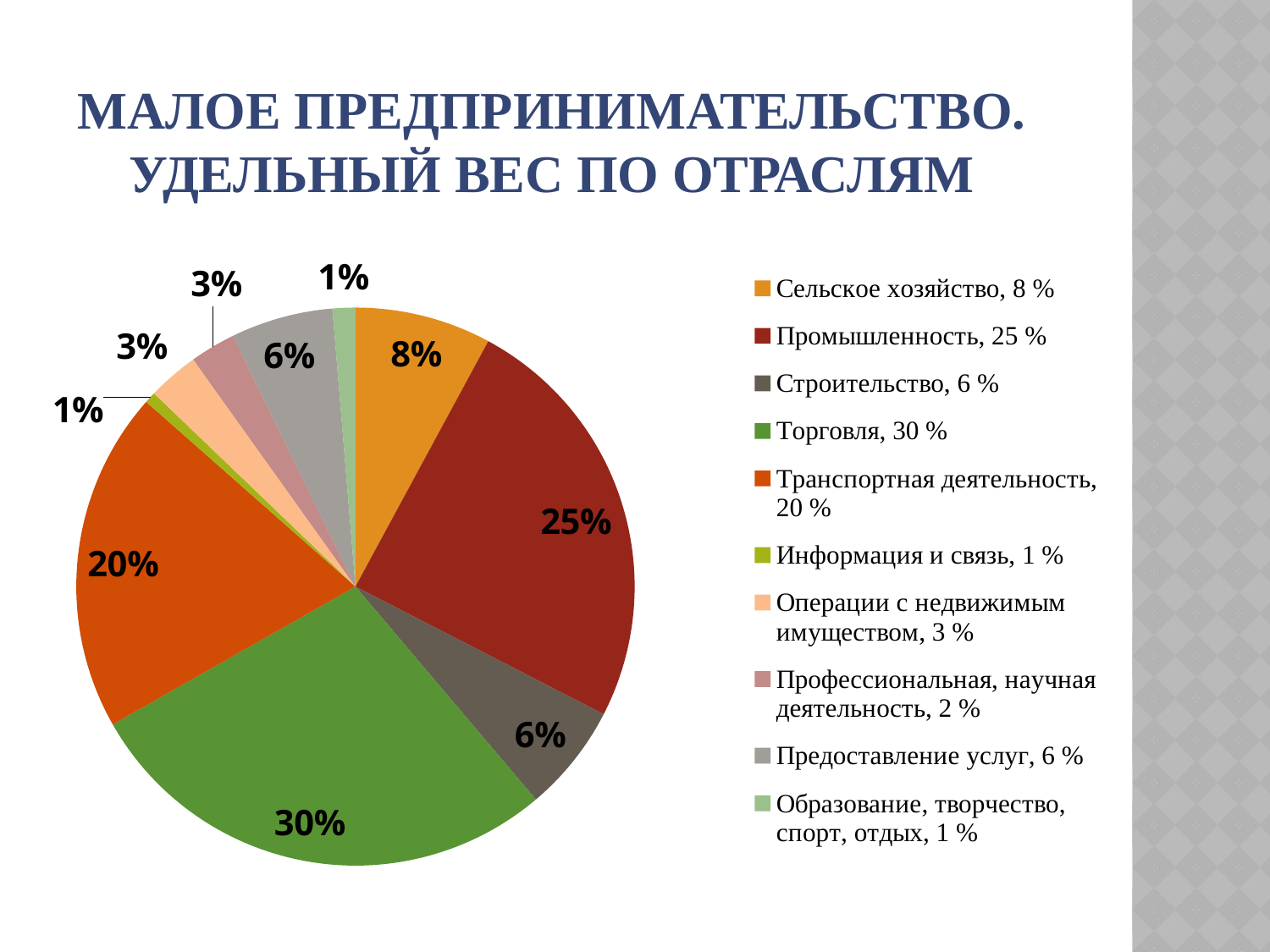
What kind of chart is shown on the slide? pie chart Which is larger, the share of Промышленность or the share of Транспортная деятельность? Промышленность By how many percentage points does the share of Торговля exceed the share of Промышленность? 5 What share does Сельское хозяйство have in the pie chart? 8% What share does Промышленность have in the pie chart? 25% What is the title of the slide containing the pie chart? Малое предпринимательство. Удельный вес по отраслям What share does Торговля have in the pie chart? 30% What share does Транспортная деятельность have in the pie chart? 20% Which is larger, the share of Сельское хозяйство or the share of Строительство? Сельское хозяйство How many slices does the pie chart have? 10 Which category has the largest slice of the pie chart? Торговля How many entries does the legend list? 10